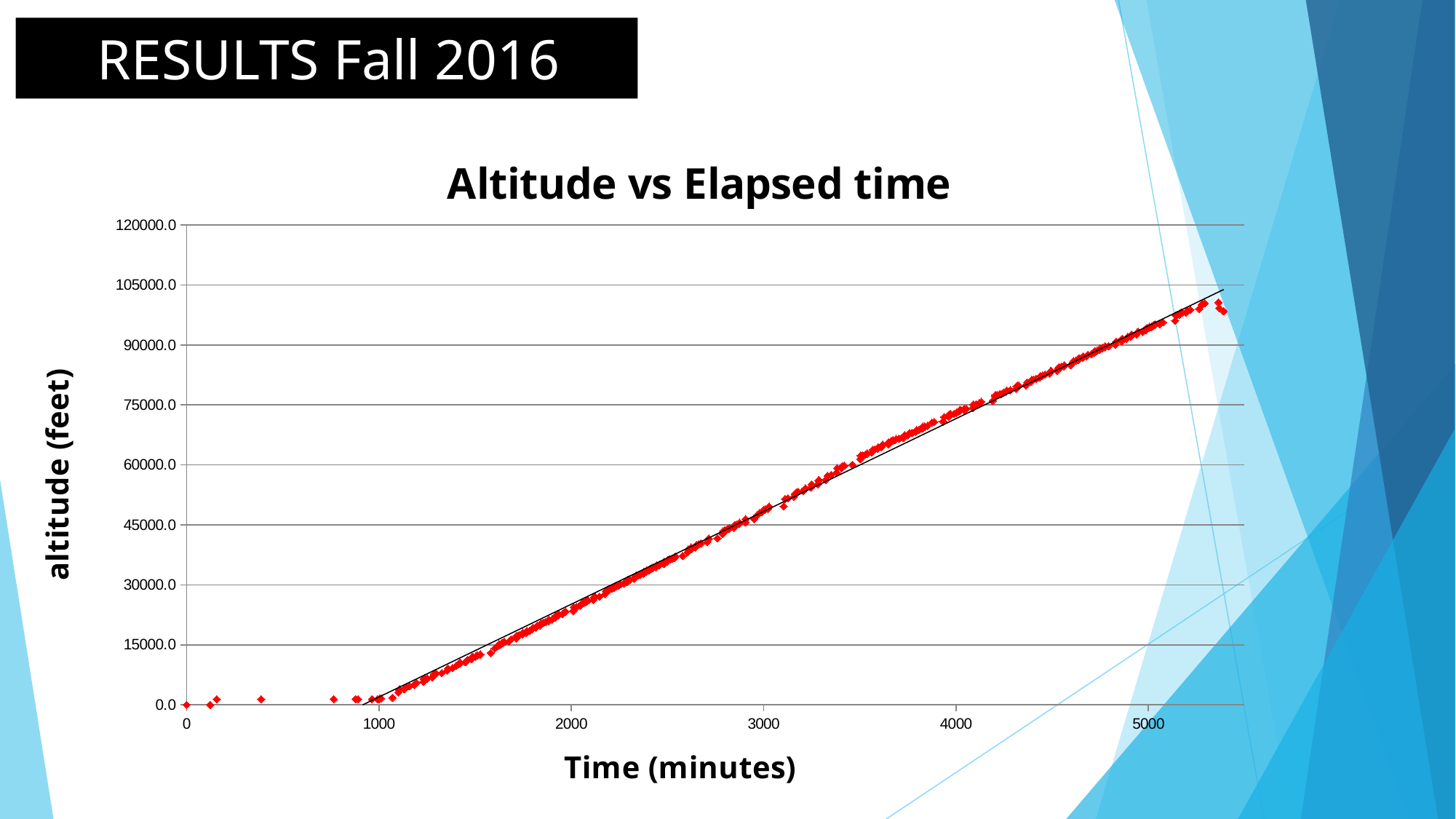
Is the highest altitude reached in the chart greater or less than 90000.0 feet? greater Is the highest altitude reached in the chart greater or less than 105000.0 feet? less What is the title of the chart? Altitude vs Elapsed time Is the altitude at a time of 2000 minutes greater or less than 30000.0 feet? less What is the label of the x axis? Time (minutes) What is the maximum value shown on the y axis? 120000.0 What kind of chart is shown on the slide? scatter chart Do the altitude values rise or fall as time increases along the x axis? rise